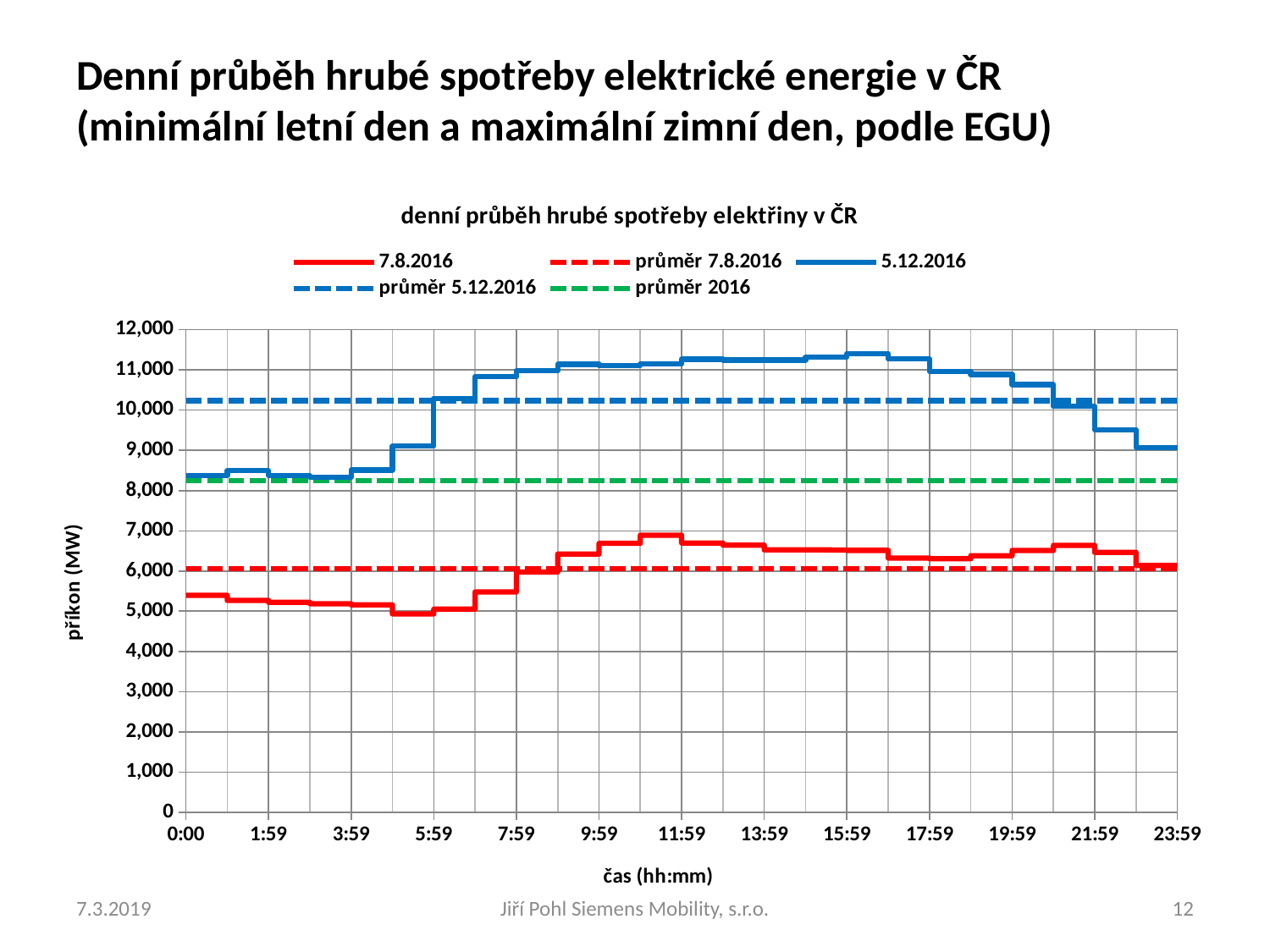
What is the title of the chart? denní průběh hrubé spotřeby elektřiny v ČR Is the peak value of the 5.12.2016 series greater or less than 11,000? greater Is the value of the 7.8.2016 series at 0:00 greater or less than 5,000? greater How many series does the legend list? 5 What kind of chart is shown on the slide? line chart Is the průměr 7.8.2016 line greater or less than 7,000? less Does the 5.12.2016 series rise or fall between 0:00 and 15:59? rise Which series has the larger value at 11:59, 7.8.2016 or 5.12.2016? 5.12.2016 What is the label of the vertical axis? příkon (MW) Does the 7.8.2016 series rise or fall between 0:00 and 4:59? fall